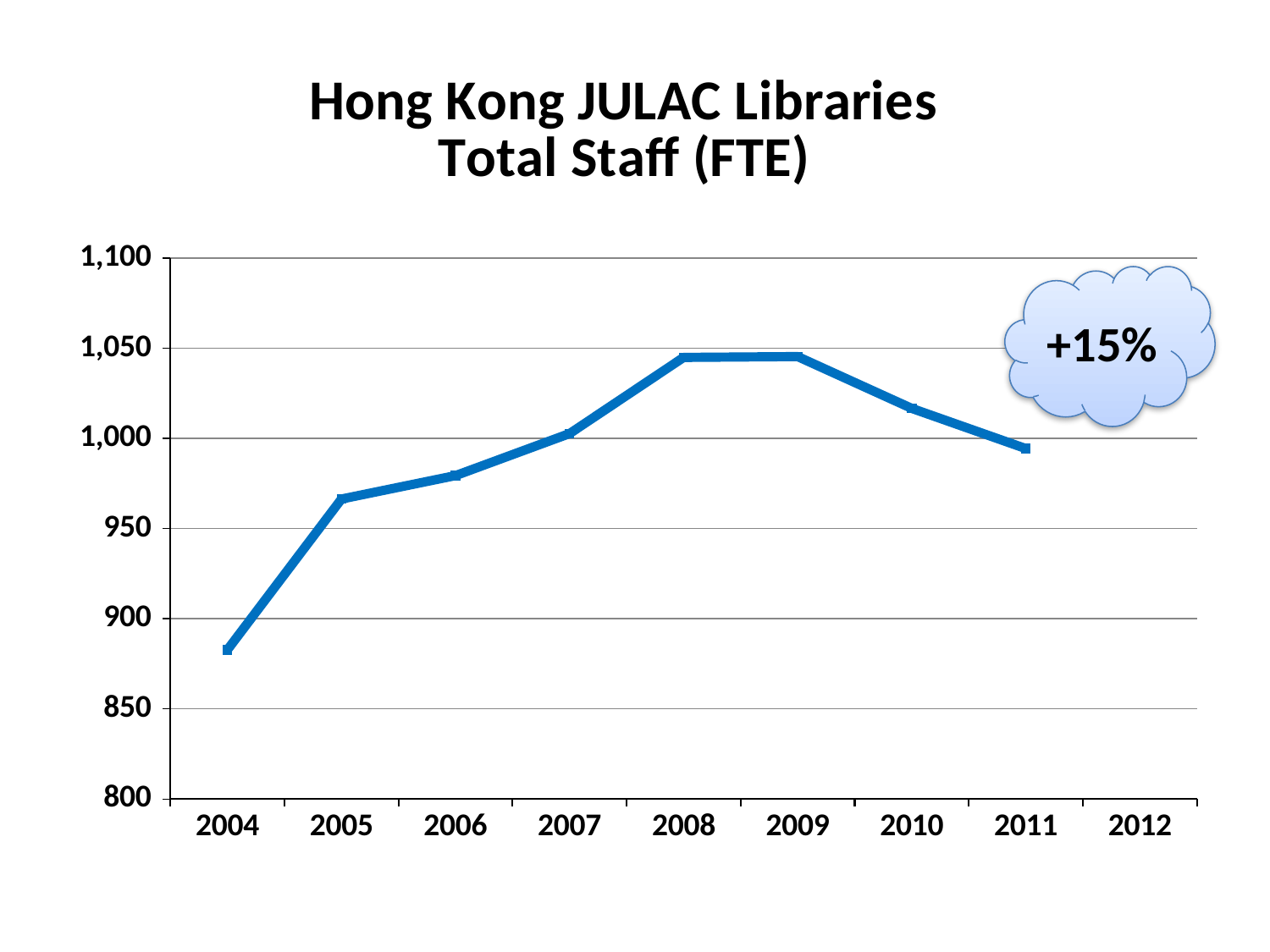
Is the value for 2008 greater or less than 1,000? greater What is the title of the chart? Hong Kong JULAC Libraries Total Staff (FTE) Is the value for 2010 greater or less than 1,050? less Is the value for 2004 greater or less than 900? less Do the values rise or fall from 2004 to 2008? rise How many years have a plotted data point on the line? 8 What kind of chart is shown on the slide? line chart What percentage is shown in the cloud annotation on the chart? +15% Which year has the lowest total staff (FTE)? 2004 Which year has the larger value, 2005 or 2010? 2010